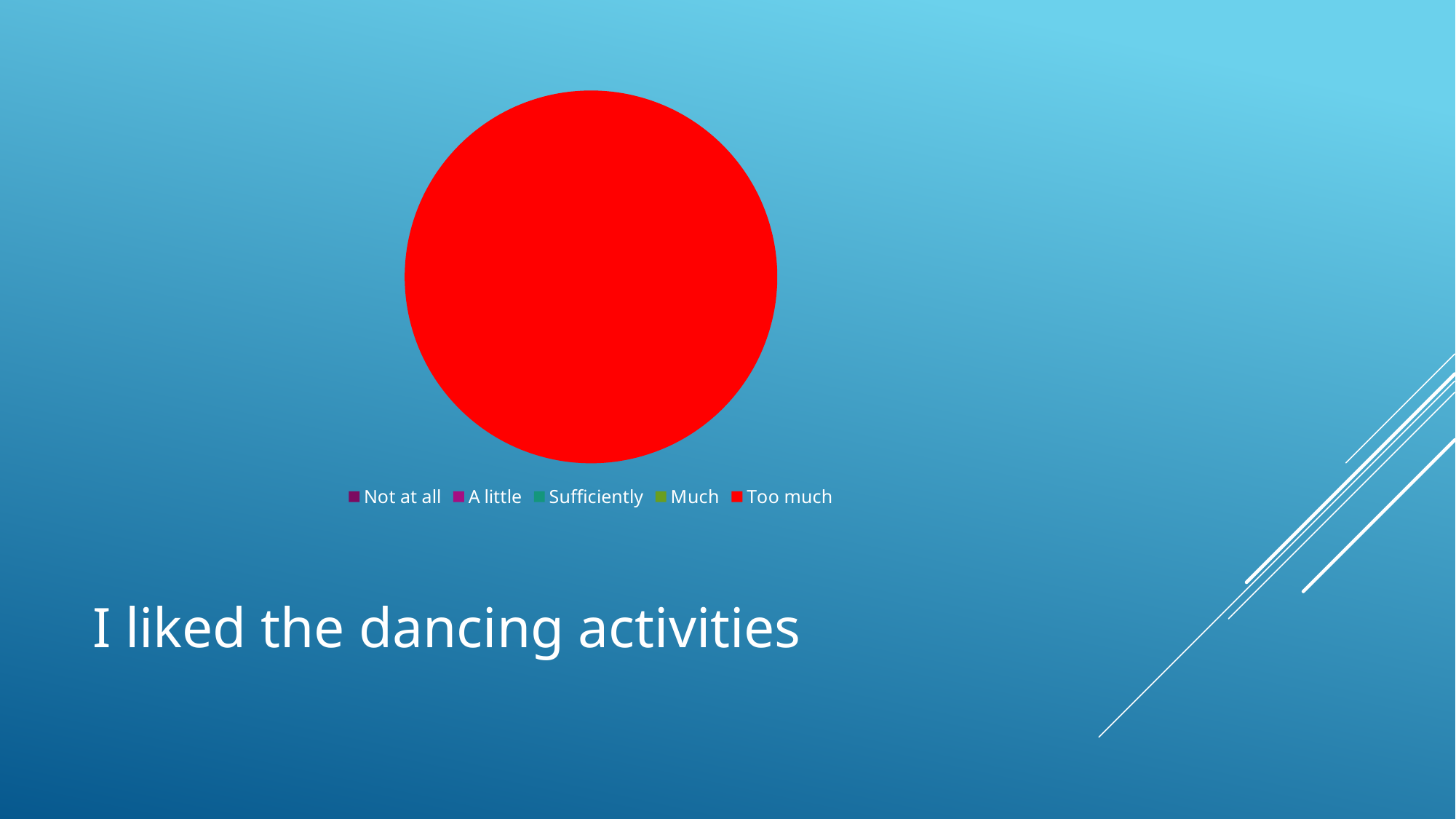
How many categories does the legend of the pie chart list? 5 How many visible slices does the pie chart have? 1 Which is larger in the pie chart, "Too much" or "Not at all"? Too much Which is larger in the pie chart, "Too much" or "Much"? Too much Which category does the red colour represent in the pie chart? Too much Which category takes up the largest share of the pie chart? Too much What kind of chart is shown on the slide? pie chart What is the first category listed in the pie chart's legend? Not at all What share of the pie chart does the "Too much" category occupy? 100%